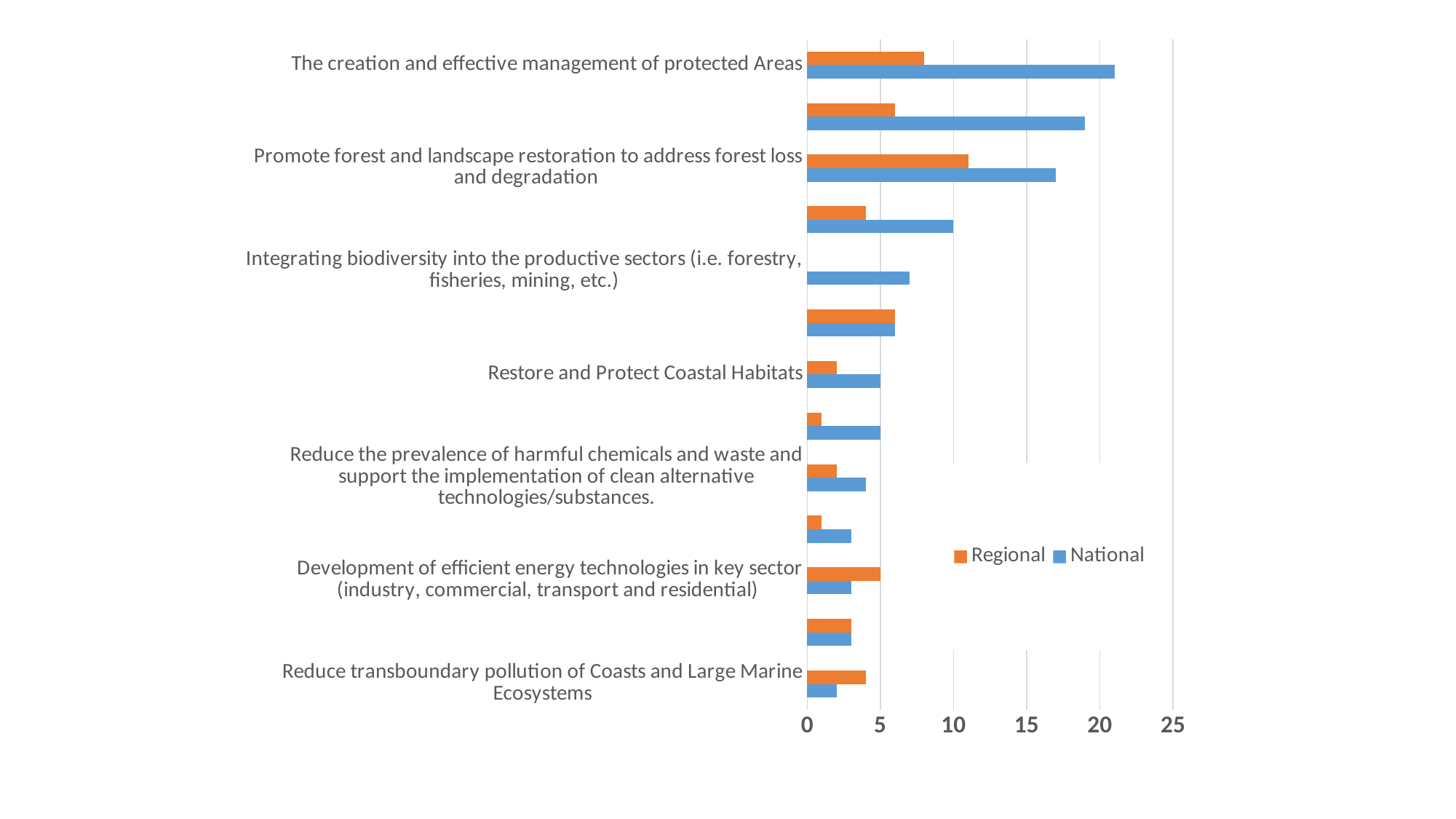
Is the National value for Integrating biodiversity into the productive sectors (i.e. forestry, fisheries, mining, etc.) greater or less than 5? greater Is the National value for Promote forest and landscape restoration to address forest loss and degradation greater or less than 15? greater Which series is shown in orange? Regional For The creation and effective management of protected Areas, which series has the larger value, Regional or National? National What is the Regional value for Development of efficient energy technologies in key sector (industry, commercial, transport and residential)? 5 What is the National value for Restore and Protect Coastal Habitats? 5 What kind of chart is shown on the slide? bar chart For Reduce transboundary pollution of Coasts and Large Marine Ecosystems, which series has the larger value, Regional or National? Regional Is the Regional value for The creation and effective management of protected Areas greater or less than 10? less Which labelled category has the highest National value? The creation and effective management of protected Areas How many series does the legend list? 2